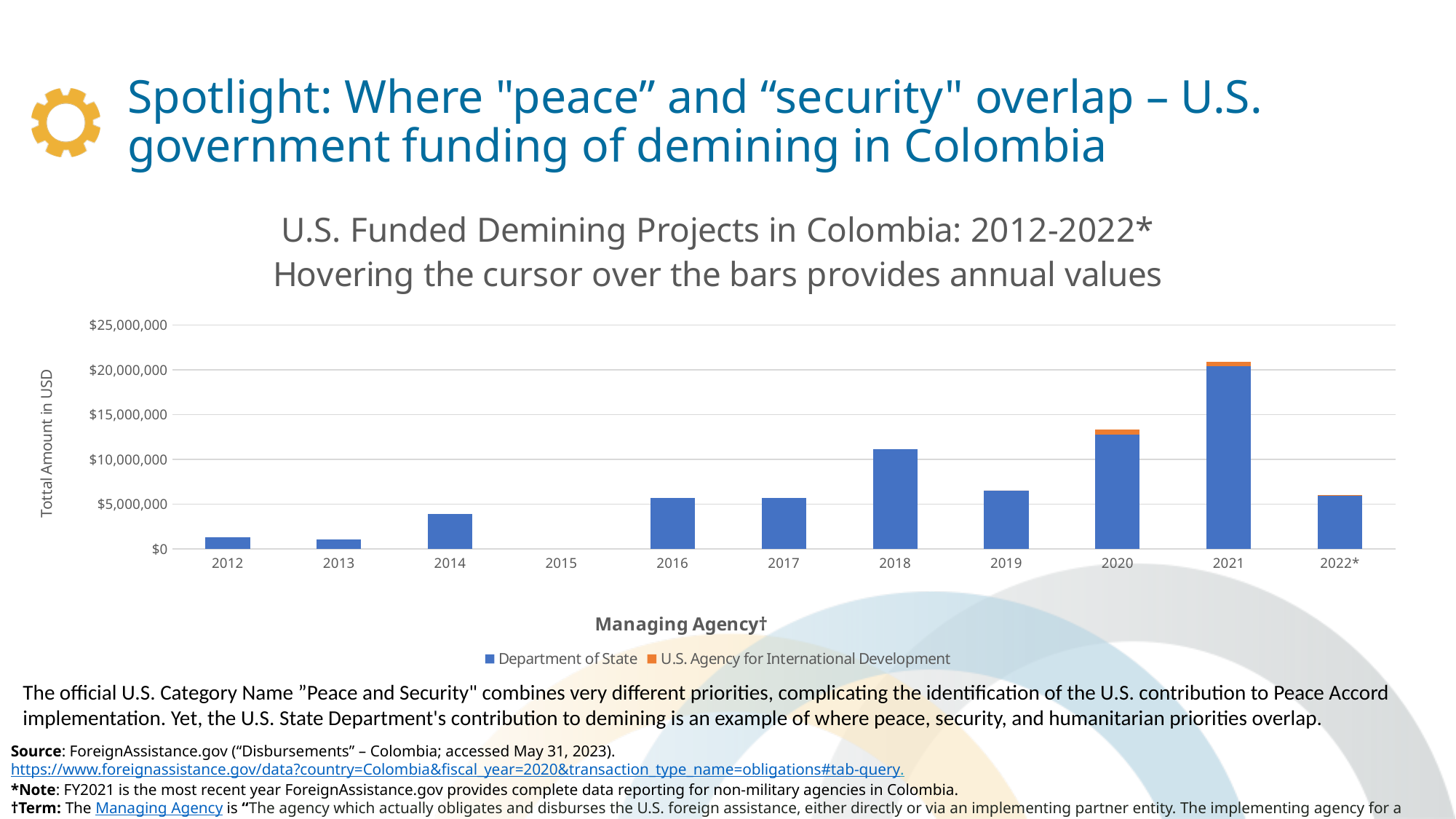
Is the value for 2014 greater or less than $5,000,000? less How many series does the legend list? 2 Which year has the larger total, 2020 or 2021? 2021 Is the total for 2021 greater or less than $15,000,000? greater How many years are shown on the x axis? 11 Is the value for 2019 greater or less than $5,000,000? greater Which year has the highest total funding? 2021 Which year shows no funding bar at all? 2015 What kind of chart is shown on the slide? Stacked bar chart Which two managing agencies are listed in the legend? Department of State; U.S. Agency for International Development Which year has the larger total, 2018 or 2019? 2018